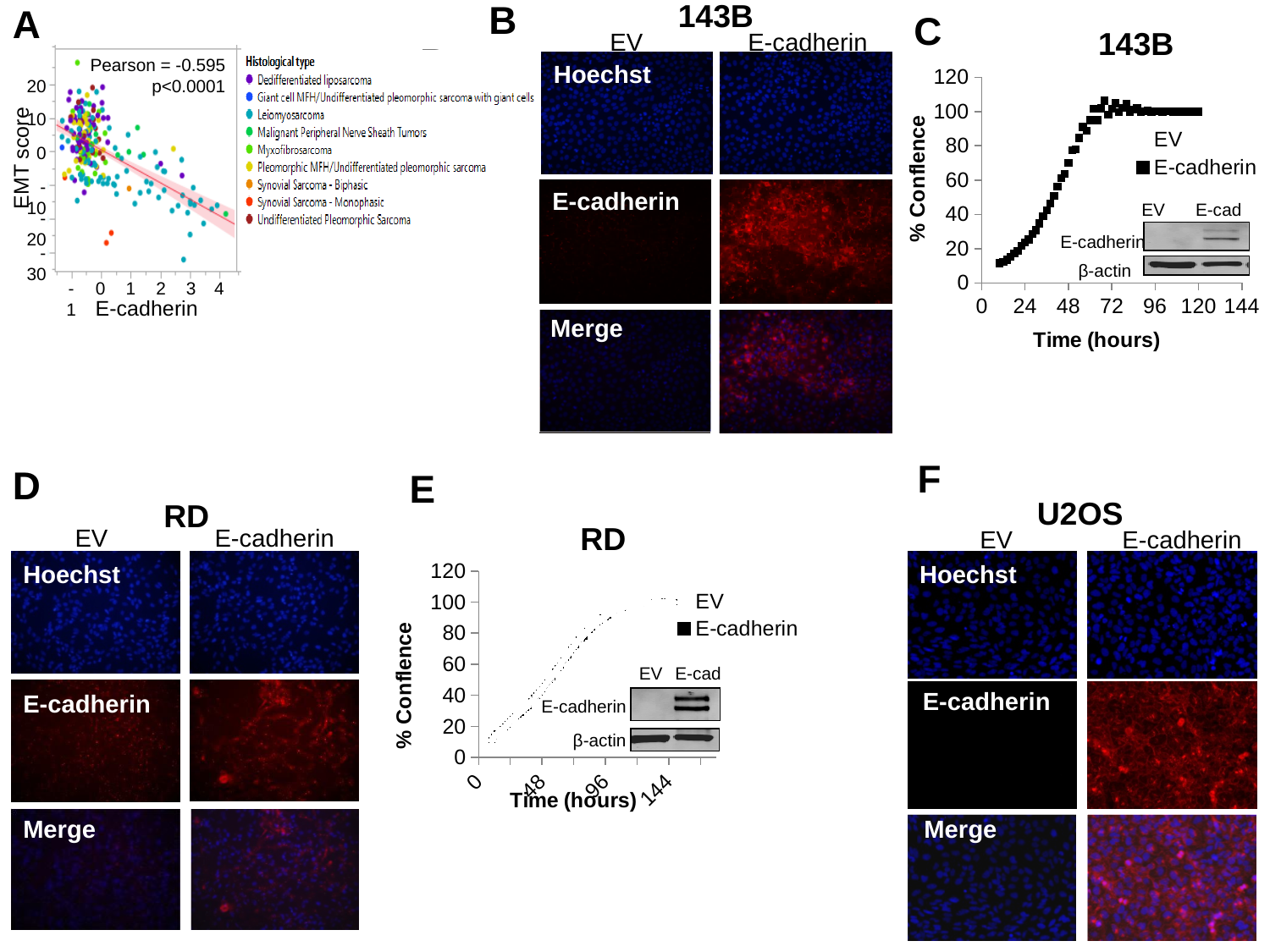
In chart E (RD), is the % Confluence at 96 hours greater or less than 60? greater In chart C (143B), is the % Confluence at 24 hours greater or less than 40? less In chart C (143B), how many series does the legend list? 2 In chart C (143B), does % Confluence rise or fall over time? rise In chart A, what is the label of the y axis? EMT score In chart C (143B), what is the label of the x axis? Time (hours) In chart A, does the EMT score tend to rise or fall as E-cadherin increases along the x axis? fall In chart C (143B), is the % Confluence at 96 hours greater or less than 80? greater What kind of chart is chart A? scatter plot In chart A, how many histological types are listed in the legend? 9 In chart A, what p-value is printed on the plot? p<0.0001 In chart A, what is the Pearson correlation value printed on the plot? -0.595